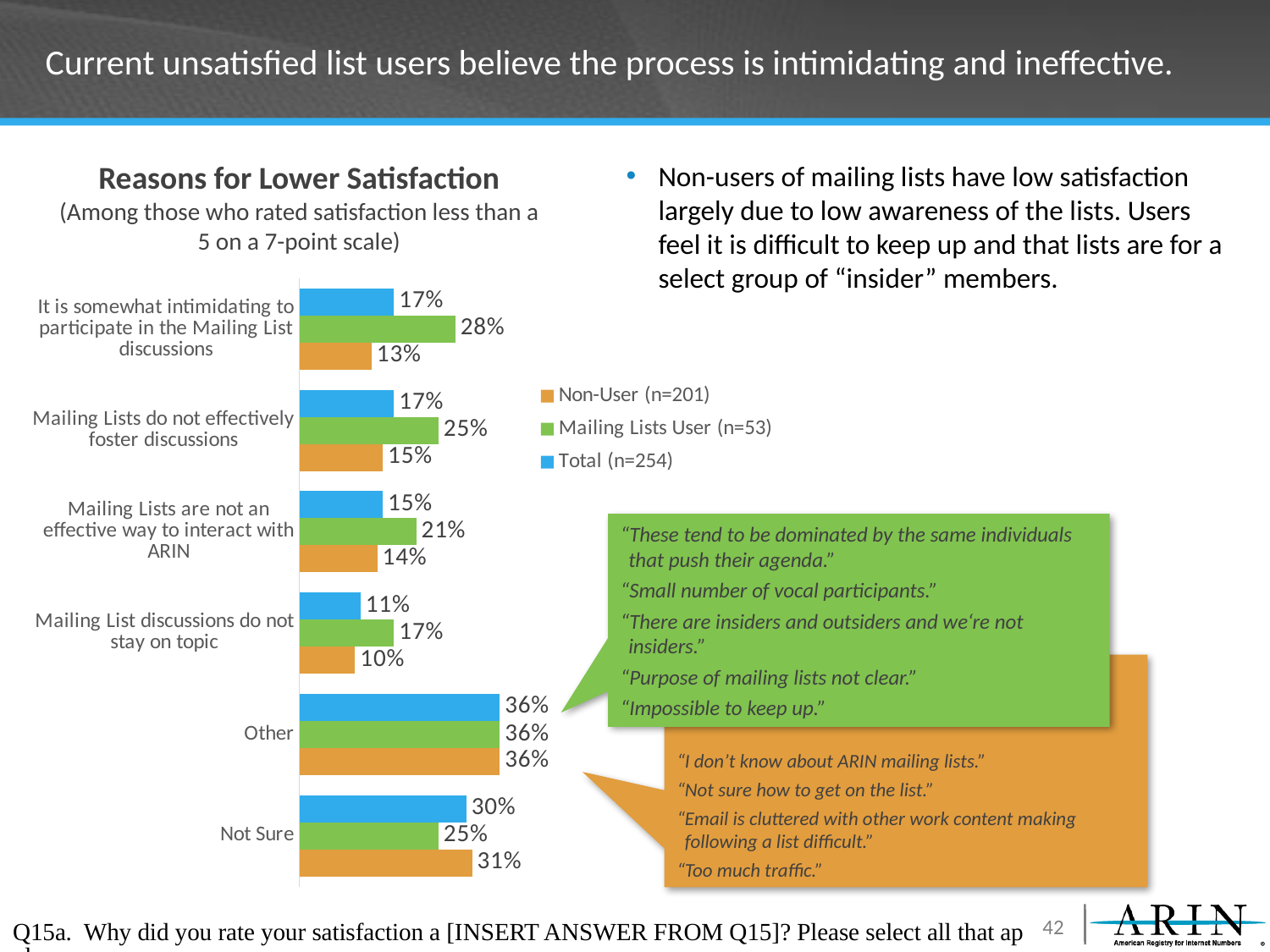
What is the Mailing Lists User (n=53) value for "It is somewhat intimidating to participate in the Mailing List discussions"? 28% What is the Total (n=254) value for "Mailing List discussions do not stay on topic"? 11% For "Not Sure", which is larger: the Total (n=254) value or the Mailing Lists User (n=53) value? Total (n=254) What is the Non-User (n=201) value for "Not Sure"? 31% How many reason categories are plotted in the "Reasons for Lower Satisfaction" chart? 6 What type of chart is shown under the title "Reasons for Lower Satisfaction"? Bar chart Which category has the highest Mailing Lists User (n=53) value? Other Which category has the lowest Non-User (n=201) value? Mailing List discussions do not stay on topic What is the difference between the Mailing Lists User and Non-User values for "It is somewhat intimidating to participate in the Mailing List discussions"? 15% What is the Non-User (n=201) value for "Mailing Lists are not an effective way to interact with ARIN"? 14% How many series does the legend of the "Reasons for Lower Satisfaction" chart list? 3 Which colour represents the Total (n=254) series in the chart? Blue